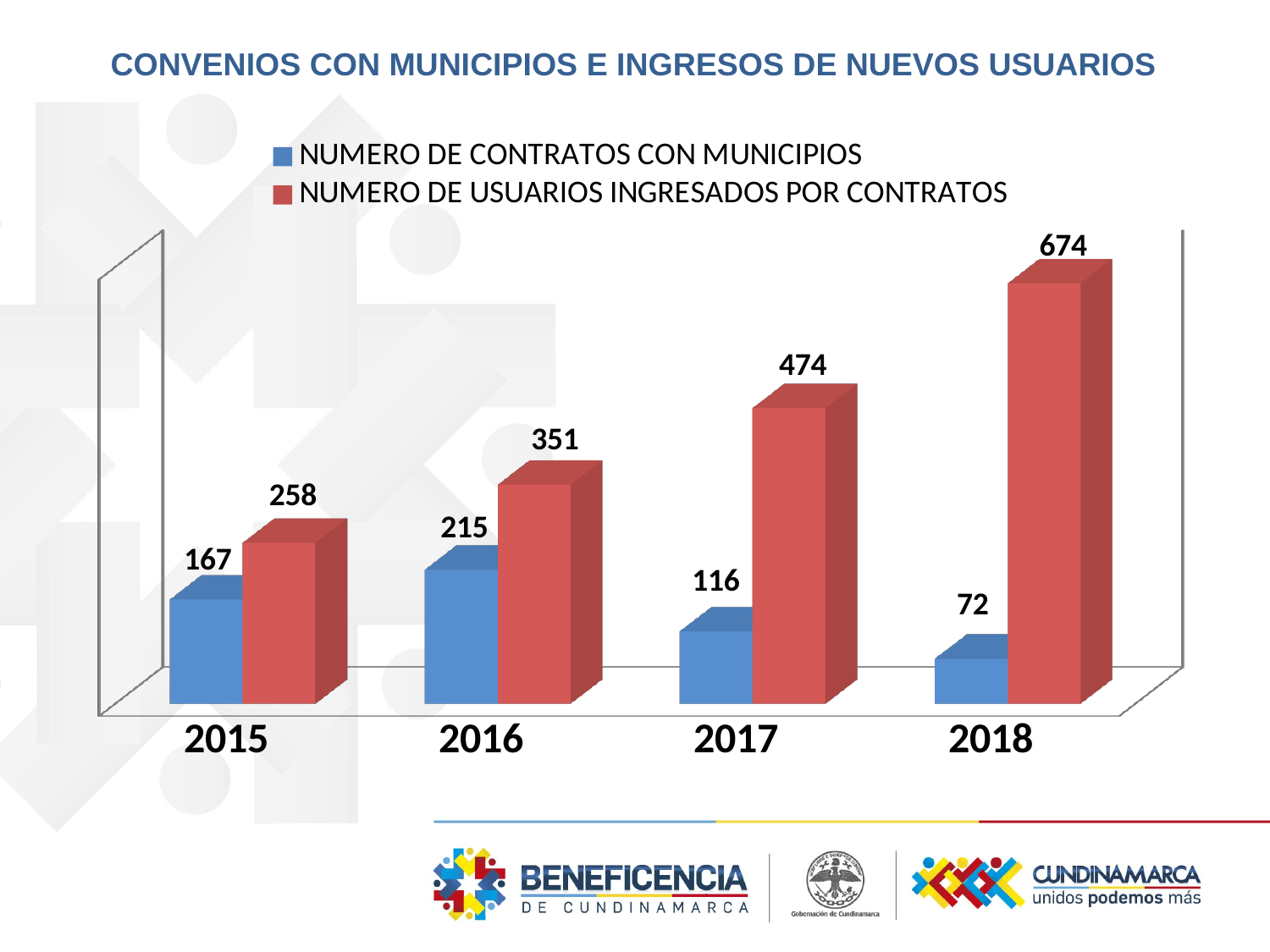
In which year is NUMERO DE CONTRATOS CON MUNICIPIOS lowest? 2018 What is the difference between NUMERO DE CONTRATOS CON MUNICIPIOS in 2016 and in 2015? 48 What is the difference between NUMERO DE USUARIOS INGRESADOS POR CONTRATOS in 2018 and in 2017? 200 In which year is NUMERO DE USUARIOS INGRESADOS POR CONTRATOS highest? 2018 Which is larger: NUMERO DE CONTRATOS CON MUNICIPIOS in 2015 or in 2017? 2015 What is the number of users entered by contracts (NUMERO DE USUARIOS INGRESADOS POR CONTRATOS) in 2018? 674 Does NUMERO DE USUARIOS INGRESADOS POR CONTRATOS rise or fall from 2015 to 2018? Rise What is the number of contracts with municipalities (NUMERO DE CONTRATOS CON MUNICIPIOS) in 2016? 215 How many series does the legend list? 2 What kind of chart is shown on the slide? Bar chart What is the value for NUMERO DE CONTRATOS CON MUNICIPIOS in 2018? 72 How many years are shown on the x axis? 4